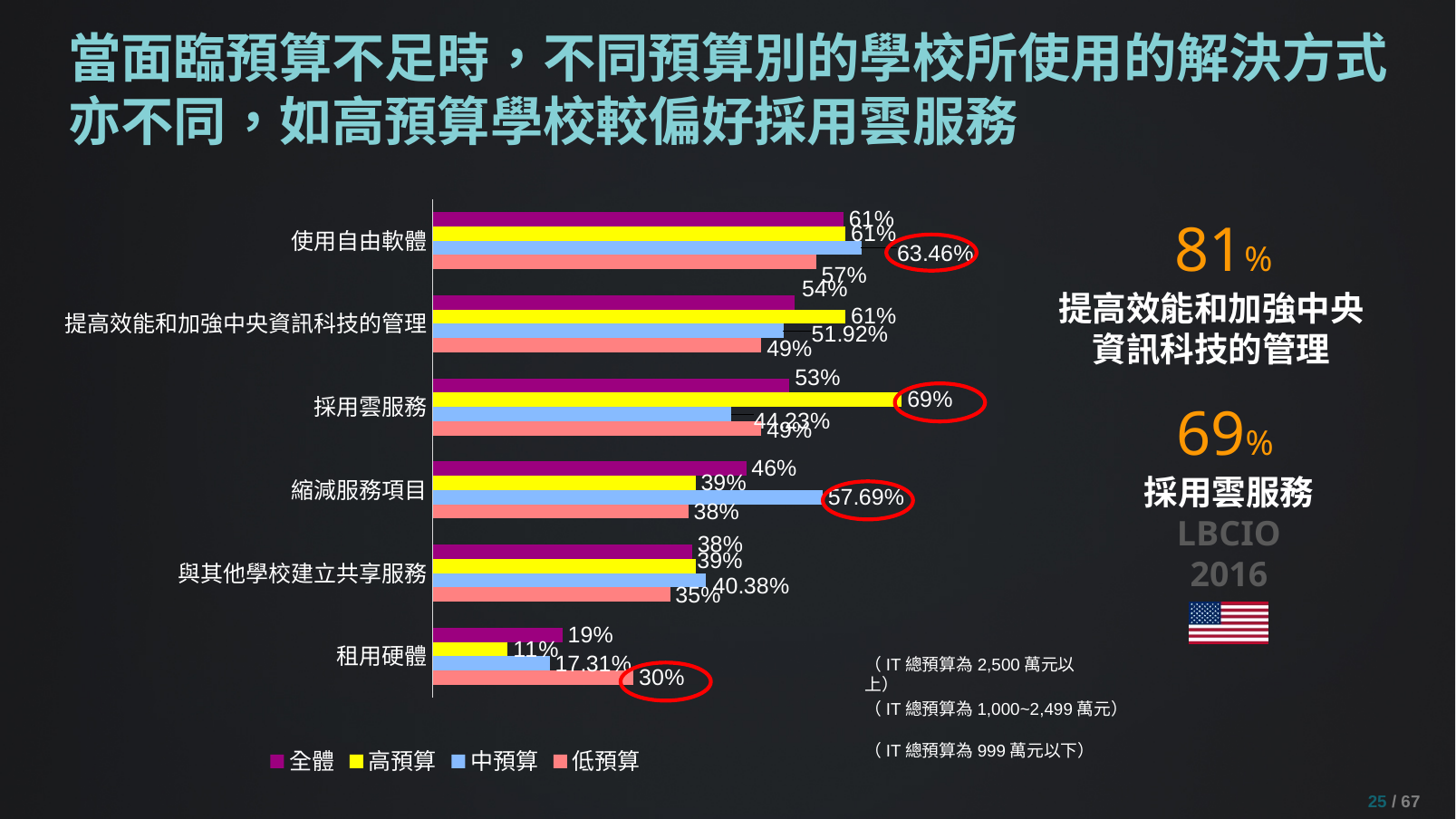
In the 租用硬體 category, which is larger: the 全體 value or the 低預算 value? 低預算 What is the value for 低預算 in the 租用硬體 category? 30% What is the value for 中預算 in the 縮減服務項目 category? 57.69% Which category has the highest value for the 中預算 series? 使用自由軟體 What is the value for 高預算 in the 採用雲服務 category? 69% Which series is shown in yellow in the legend? 高預算 How many categories are shown on the chart? 6 What is the difference between the 高預算 and 低預算 values in the 採用雲服務 category? 20% What type of chart is shown on the slide? bar chart Which category has the lowest value for the 高預算 series? 租用硬體 How many series does the chart legend list? 4 What is the value for 全體 in the 使用自由軟體 category? 61%